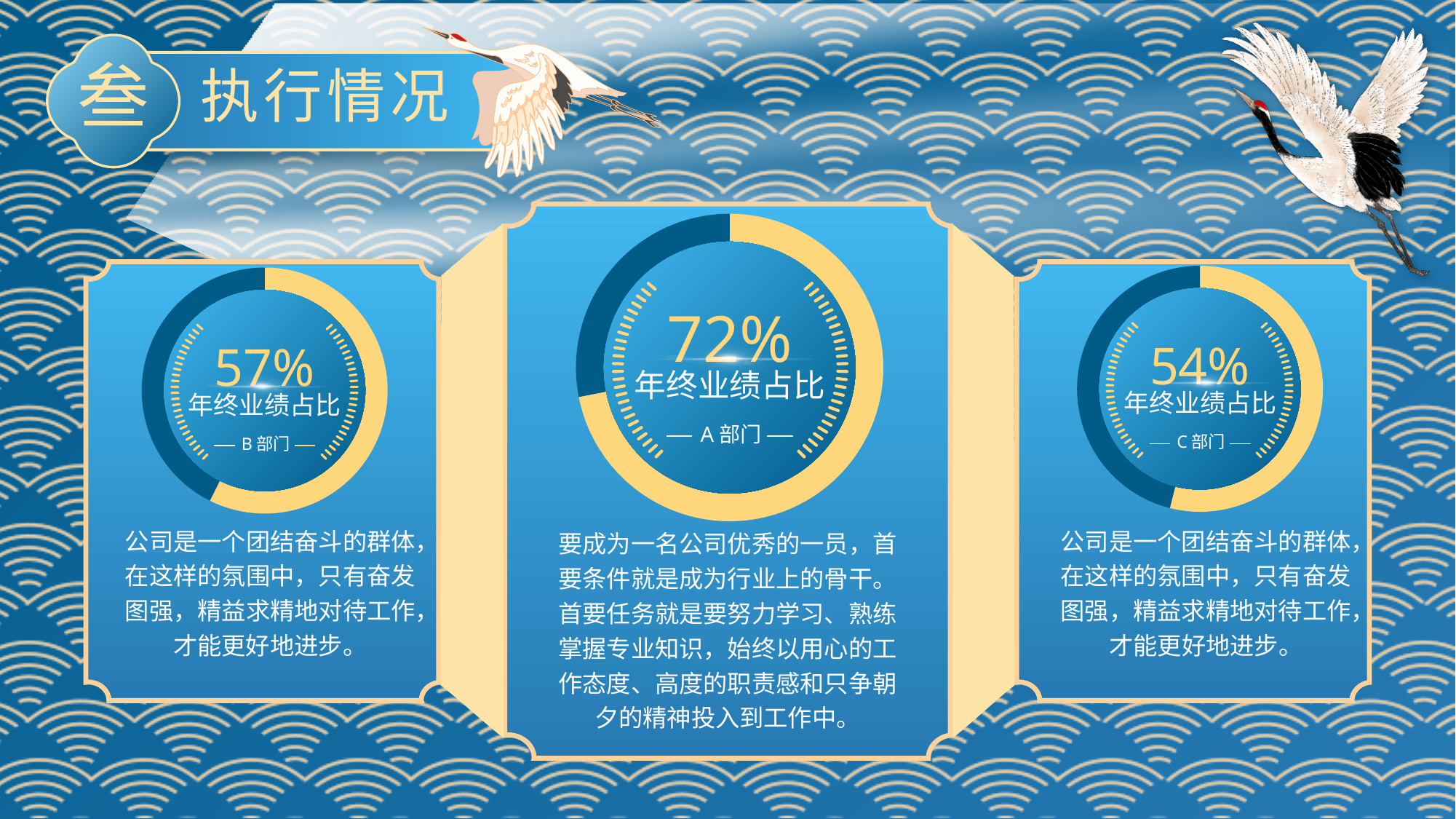
What colour is the filled portion of the ring in the middle chart for A 部门? Yellow Which department has the highest 年终业绩占比 among the three ring charts? A 部门 What is the 年终业绩占比 value shown for B 部门 in the left chart? 57% How many ring charts are shown on the slide? 3 What is the difference between the B 部门 value in the left chart and the C 部门 value in the right chart? 3% What is the 年终业绩占比 value shown for C 部门 in the right chart? 54% What kind of chart is used to show each department's 年终业绩占比? Donut (ring) chart What is the difference between the A 部门 value in the middle chart and the B 部门 value in the left chart? 15% What is the section title shown at the top left of the slide? 执行情况 Which is larger, the value for A 部门 in the middle chart or the value for C 部门 in the right chart? A 部门 Which department has the lowest 年终业绩占比 among the three ring charts? C 部门 What is the 年终业绩占比 value shown for A 部门 in the middle chart? 72%